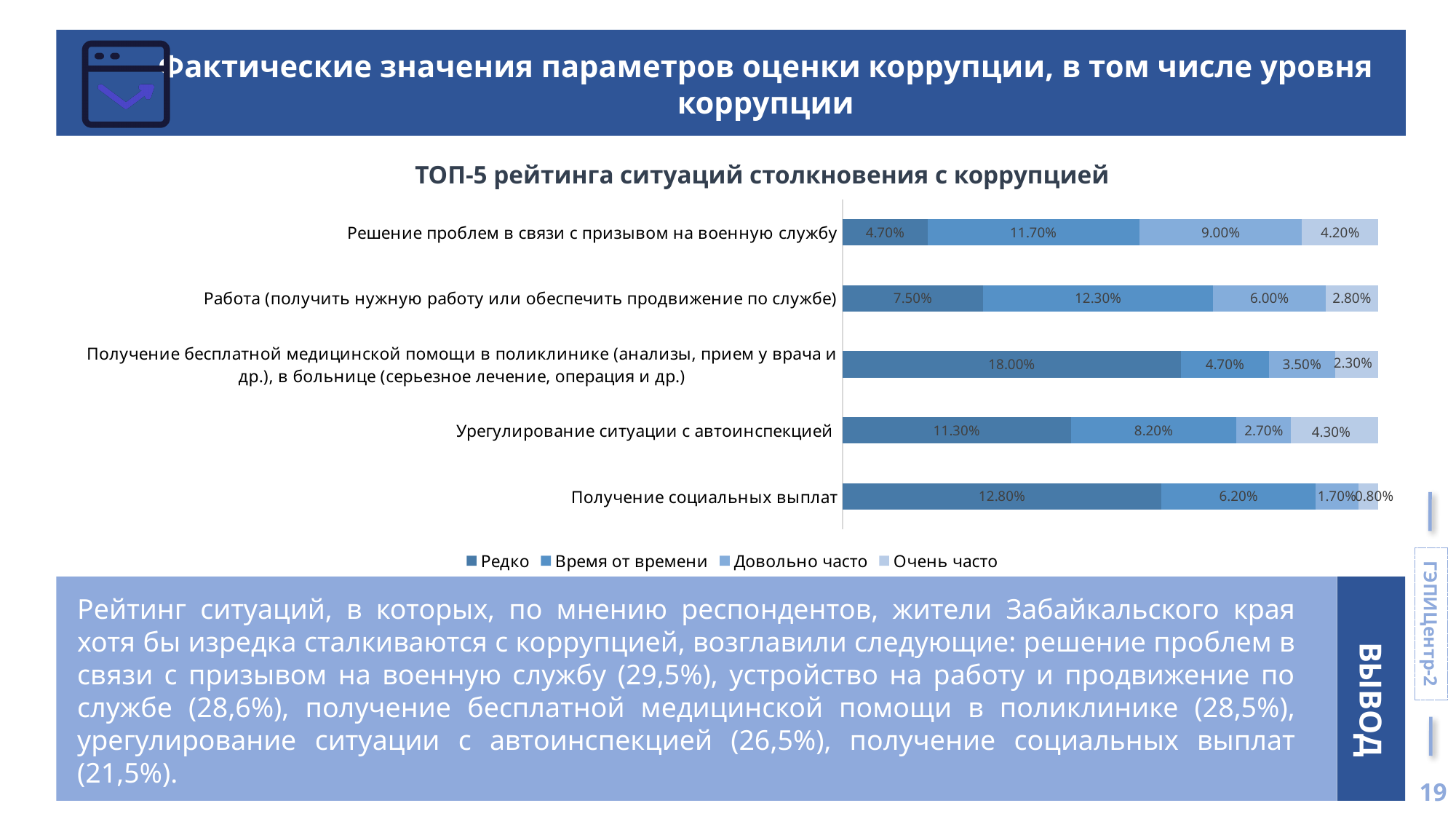
What is the title of the chart? ТОП-5 рейтинга ситуаций столкновения с коррупцией Which category has the lowest value in the 'Очень часто' series? Получение социальных выплат What is the total of the stacked bar for 'Работа (получить нужную работу или обеспечить продвижение по службе)'? 28.60% What kind of chart is shown on the slide? Stacked bar chart How many categories are shown in the chart? 5 For 'Решение проблем в связи с призывом на военную службу', what is the difference between the 'Время от времени' value and the 'Довольно часто' value? 2.70% Which category has the highest value in the 'Редко' series? Получение бесплатной медицинской помощи в поликлинике (анализы, прием у врача и др.), в больнице (серьезное лечение, операция и др.) What is the value of the 'Редко' series for 'Получение социальных выплат'? 12.80% How many series does the legend list? 4 What is the value of the 'Время от времени' series for 'Работа (получить нужную работу или обеспечить продвижение по службе)'? 12.30% What is the value of the 'Очень часто' series for 'Урегулирование ситуации с автоинспекцией'? 4.30% Which has the larger 'Редко' value: 'Работа (получить нужную работу или обеспечить продвижение по службе)' or 'Урегулирование ситуации с автоинспекцией'? Урегулирование ситуации с автоинспекцией